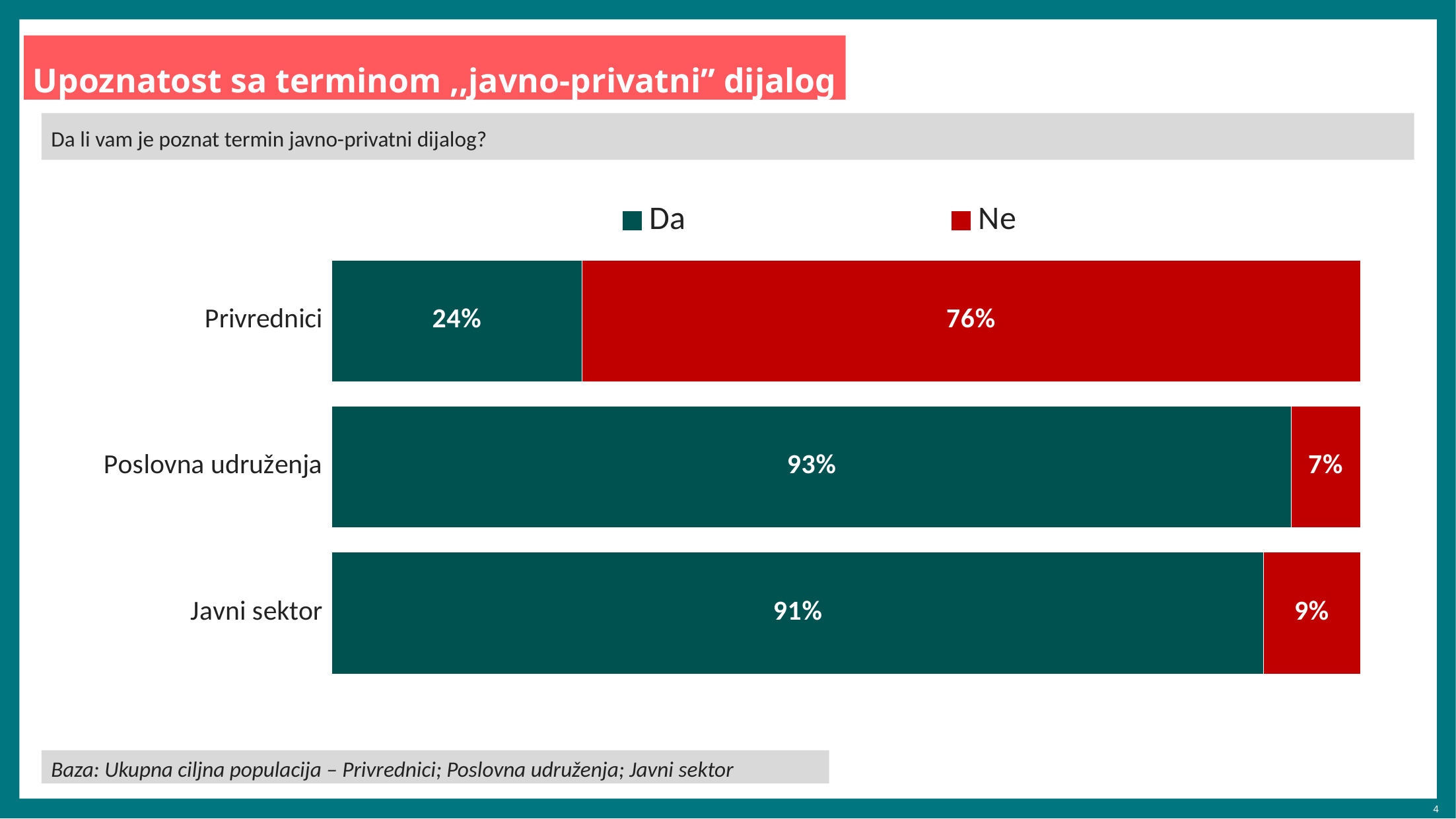
Which category has the highest "Ne" value? Privrednici Which category has the lowest "Da" value? Privrednici Which is larger: the "Da" value for Poslovna udruženja or the "Da" value for Javni sektor? Poslovna udruženja What is the "Da" value for Javni sektor? 91% What kind of chart is shown on the slide? Stacked bar chart How many series does the legend list? 2 What is the "Ne" value for Poslovna udruženja? 7% How many categories are shown in the chart? 3 What is the total of the stacked bar for Javni sektor? 100% What is the difference between the "Ne" values for Privrednici and Javni sektor? 67% What is the "Da" value for Privrednici? 24% Which category has the highest "Da" value? Poslovna udruženja